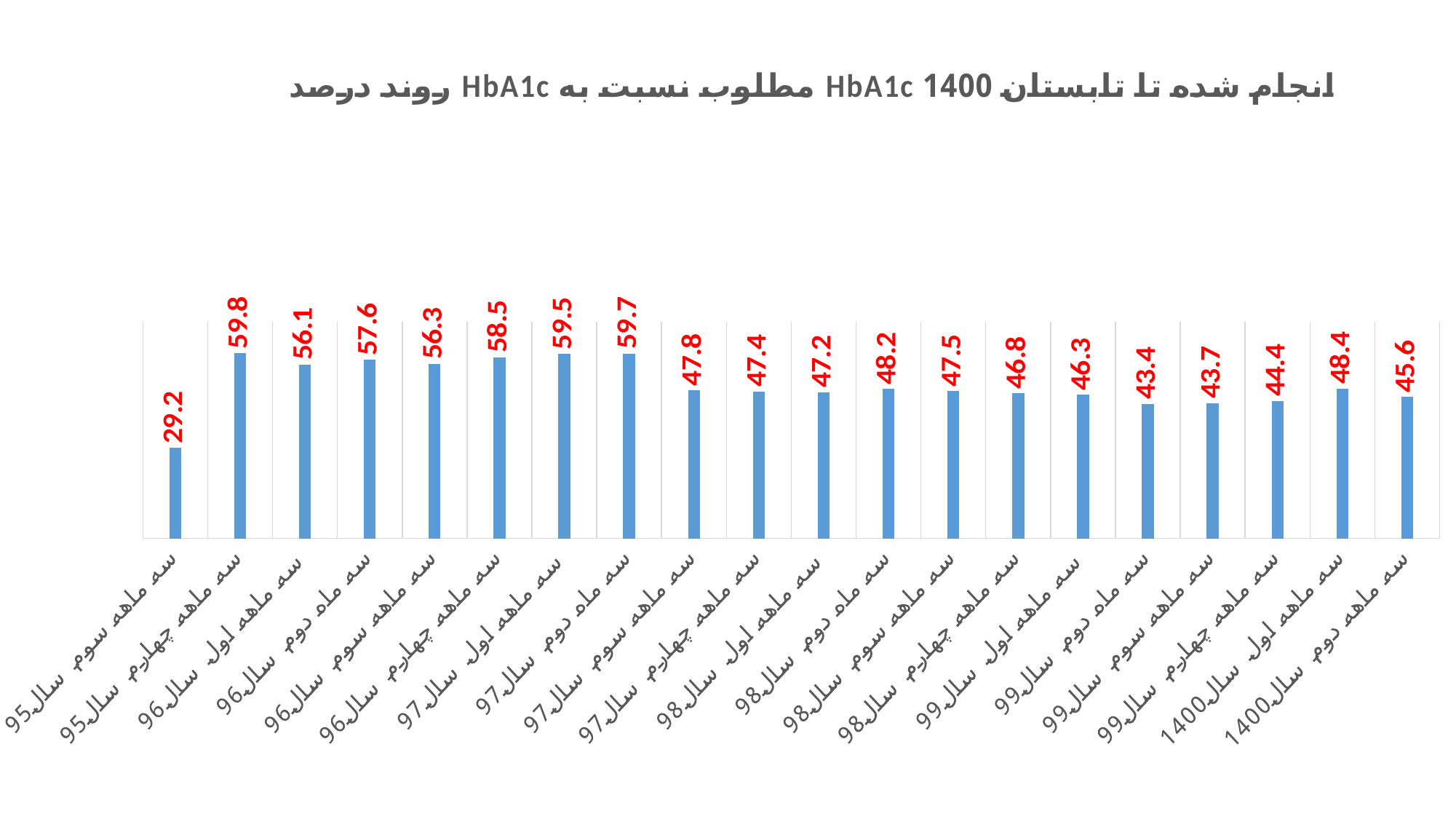
What is the value for سه ماهه دوم سال1400? 45.6 Do the values generally rise or fall from سه ماه دوم سال97 to سه ماه دوم سال99? fall What is the value for سه ماه دوم سال97? 59.7 What type of chart is shown on the slide? bar chart What is the value for سه ماهه اول سال1400? 48.4 How many bars (categories) are plotted in the chart? 20 Which category has the lowest value? سه ماهه سوم سال95 What colour are the bars in the chart? blue What is the value for سه ماهه سوم سال95? 29.2 Which is larger, the value for سه ماه دوم سال97 or the value for سه ماهه سوم سال97? سه ماه دوم سال97 What is the difference between the values for سه ماهه چهارم سال95 and سه ماهه سوم سال95? 30.6 Which category has the highest value? سه ماهه چهارم سال95